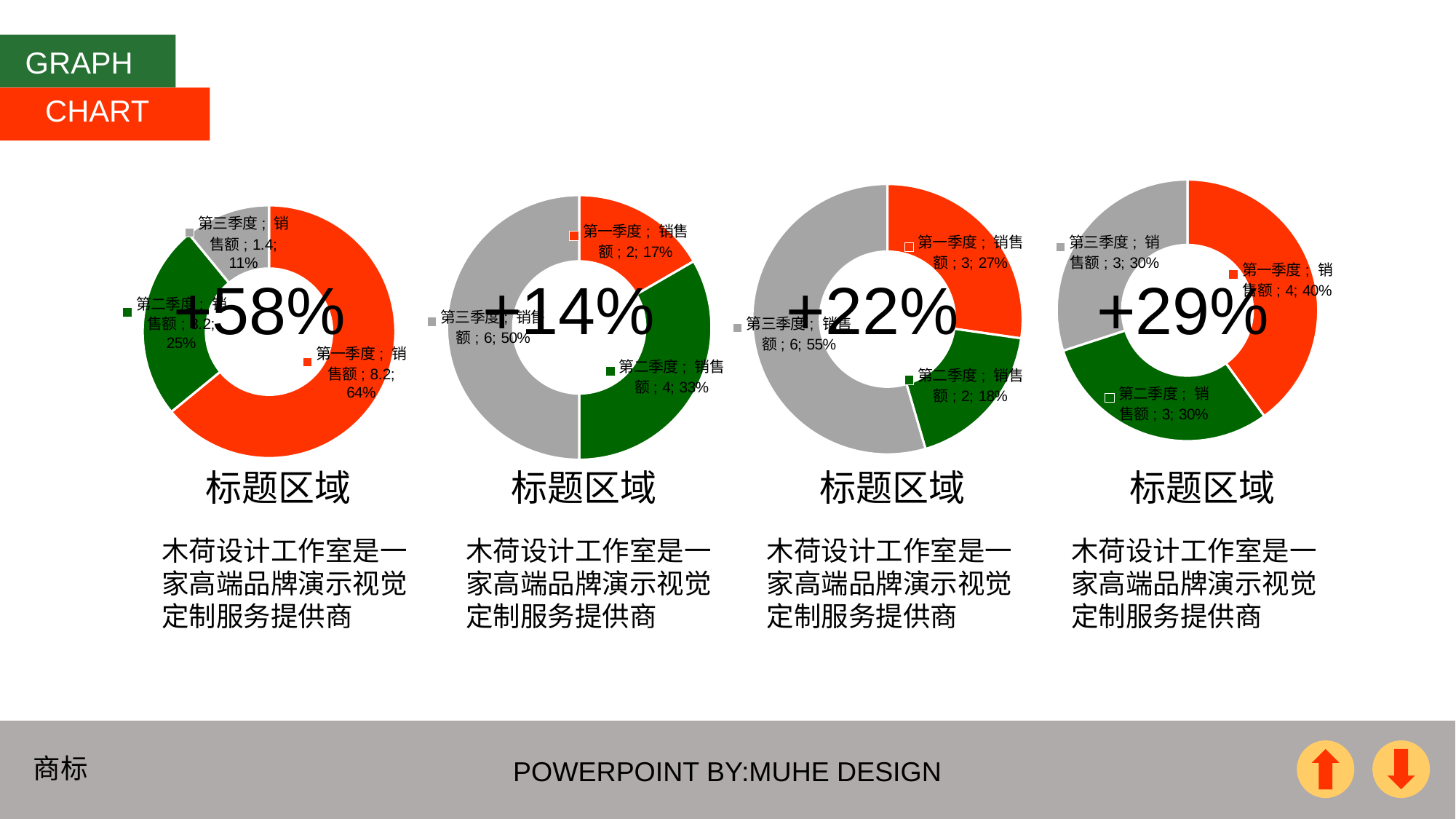
In the leftmost doughnut chart (with +58% in the centre), what is the value for 第一季度? 8.2 In the third doughnut chart from the left (with +22% in the centre), what share of the pie does 第三季度 take? 55% In the rightmost doughnut chart (with +29% in the centre), what share of the pie does 第二季度 take? 30% In the second doughnut chart from the left (with +14% in the centre), what is the difference between the values for 第二季度 and 第一季度? 2 In the second doughnut chart from the left (with +14% in the centre), what is the value for 第三季度? 6 What kind of chart is the leftmost chart on the slide? Doughnut chart In the second doughnut chart from the left (with +14% in the centre), which category has the smallest slice? 第一季度 How many categories does the rightmost doughnut chart (with +29% in the centre) show? 3 In the leftmost doughnut chart (with +58% in the centre), which category has the largest slice? 第一季度 In the rightmost doughnut chart (with +29% in the centre), what is the value for 第一季度? 4 In the third doughnut chart from the left (with +22% in the centre), which is larger, the value for 第一季度 or 第二季度? 第一季度 In the leftmost doughnut chart (with +58% in the centre), what share of the pie does 第三季度 take? 11%